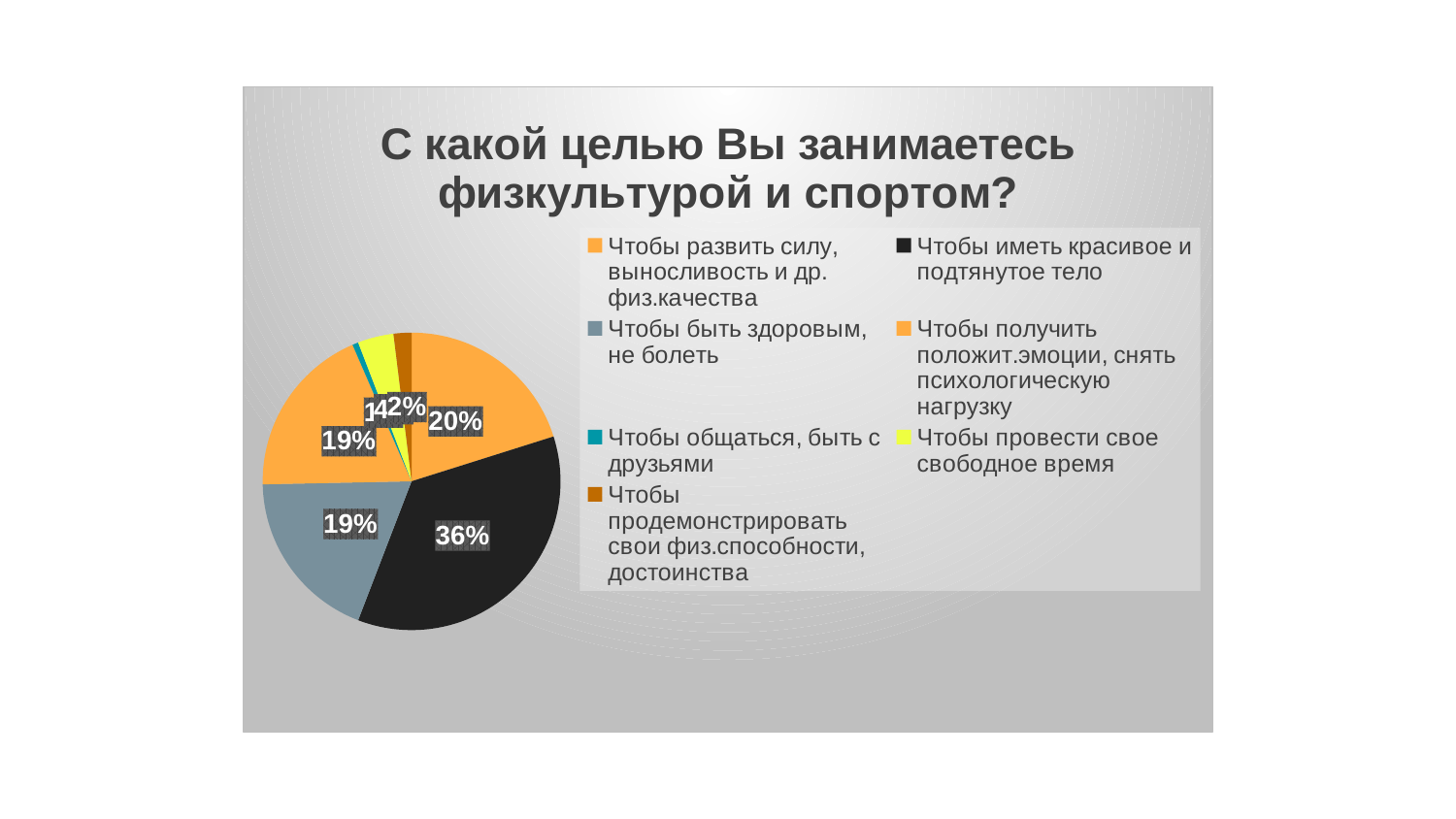
What is the title of the chart? С какой целью Вы занимаетесь физкультурой и спортом? What is the value shown for "Чтобы получить положит.эмоции, снять психологическую нагрузку"? 19% What share of the pie is labelled for "Чтобы иметь красивое и подтянутое тело"? 36% What kind of chart is shown on the slide? pie chart What is the difference in percentage points between the slice for "Чтобы развить силу, выносливость и др. физ.качества" and the slice for "Чтобы быть здоровым, не болеть"? 1 What is the value shown for "Чтобы развить силу, выносливость и др. физ.качества"? 20% Which is larger: the slice for "Чтобы иметь красивое и подтянутое тело" or the slice for "Чтобы развить силу, выносливость и др. физ.качества"? Чтобы иметь красивое и подтянутое тело Which category has the largest slice of the pie? Чтобы иметь красивое и подтянутое тело What is the difference in percentage points between the slice for "Чтобы иметь красивое и подтянутое тело" and the slice for "Чтобы развить силу, выносливость и др. физ.качества"? 16 What is the value shown for "Чтобы быть здоровым, не болеть"? 19% What colour is the largest slice of the pie? black How many categories does the legend list? 7